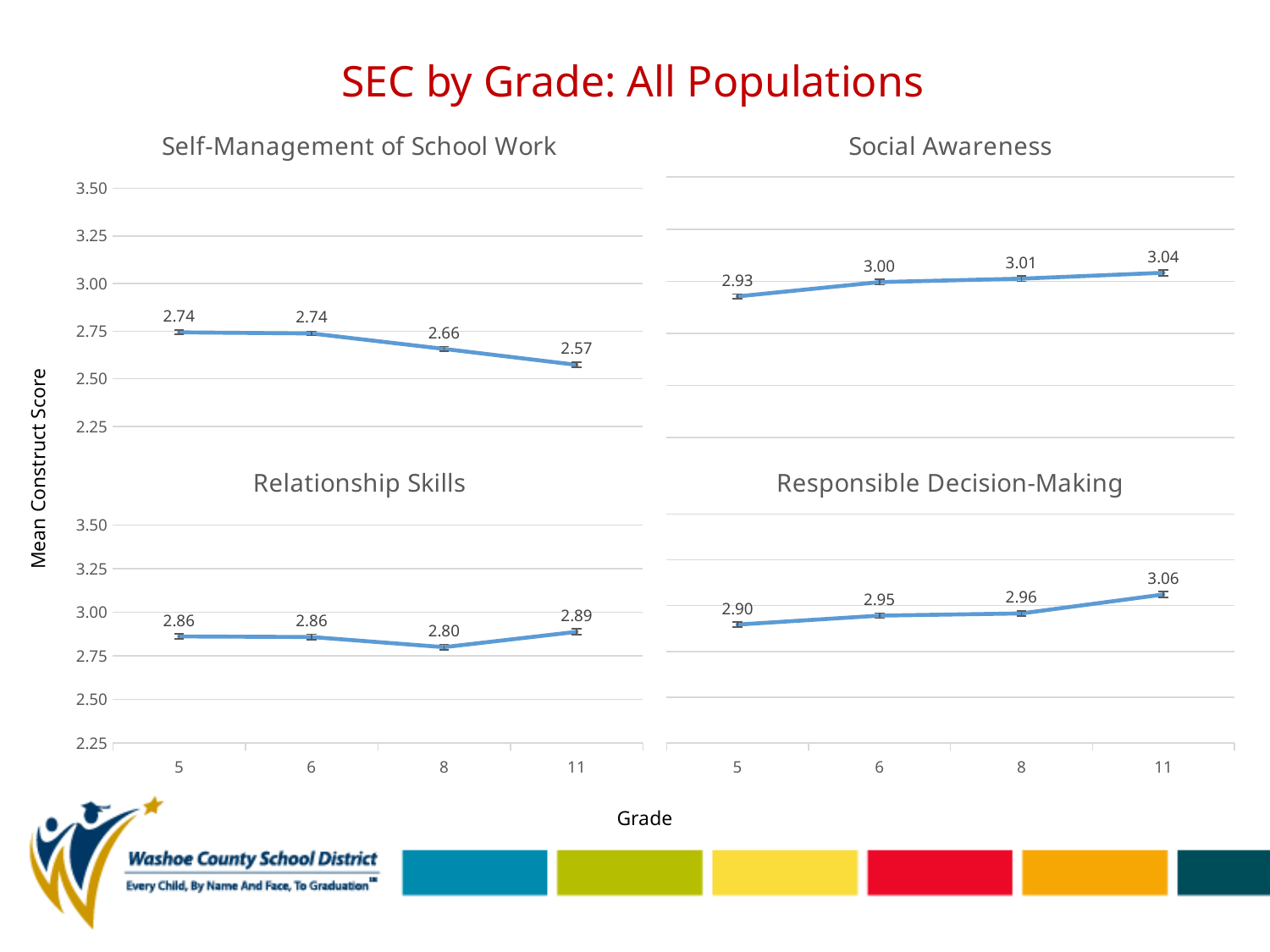
In the Social Awareness chart, is the value for grade 5 greater or less than 3.00? less How many grades are plotted in the Relationship Skills chart? 4 In the Social Awareness chart, what is the value for grade 11? 3.04 In the Self-Management of School Work chart, what is the difference between the grade 5 value and the grade 11 value? 0.17 In the Self-Management of School Work chart, do the values rise or fall from grade 6 to grade 11? Fall What is the title of the slide? SEC by Grade: All Populations In the Relationship Skills chart, which grade has the lowest value? 8 In the Self-Management of School Work chart, what is the mean construct score for grade 8? 2.66 What kind of chart is the Social Awareness chart? Line chart In the Responsible Decision-Making chart, is the value for grade 5 or grade 11 larger? Grade 11 In the Responsible Decision-Making chart, which grade has the highest value? 11 In the Relationship Skills chart, what is the value for grade 11? 2.89